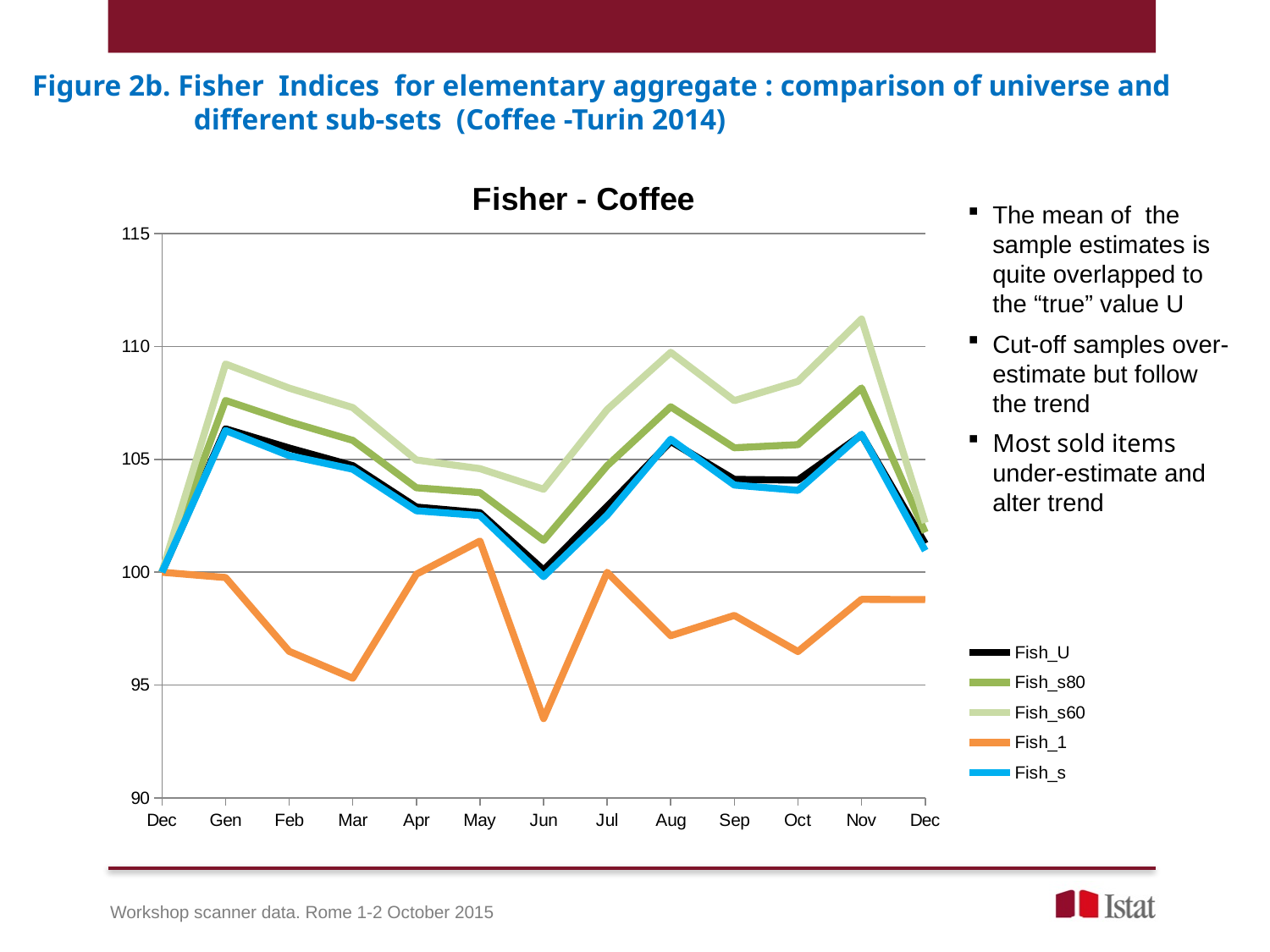
Does the Fish_1 series rise or fall from the first Dec to Mar? fall What is the value of Fish_U at the first Dec on the x axis? 100 How many series does the legend of the chart list? 5 In which month does Fish_1 reach its lowest value? Jun Is the value of Fish_1 in Jun greater or less than 95? less In Aug, which series has the higher value, Fish_s60 or Fish_1? Fish_s60 In which month does Fish_s60 reach its highest value? Nov Is the value of Fish_U in Gen greater or less than 105? greater How many points are there along the x axis of the chart? 13 Is the value of Fish_s60 in Nov greater or less than 110? greater What kind of chart is shown on the slide? line chart What is the title of the chart? Fisher - Coffee